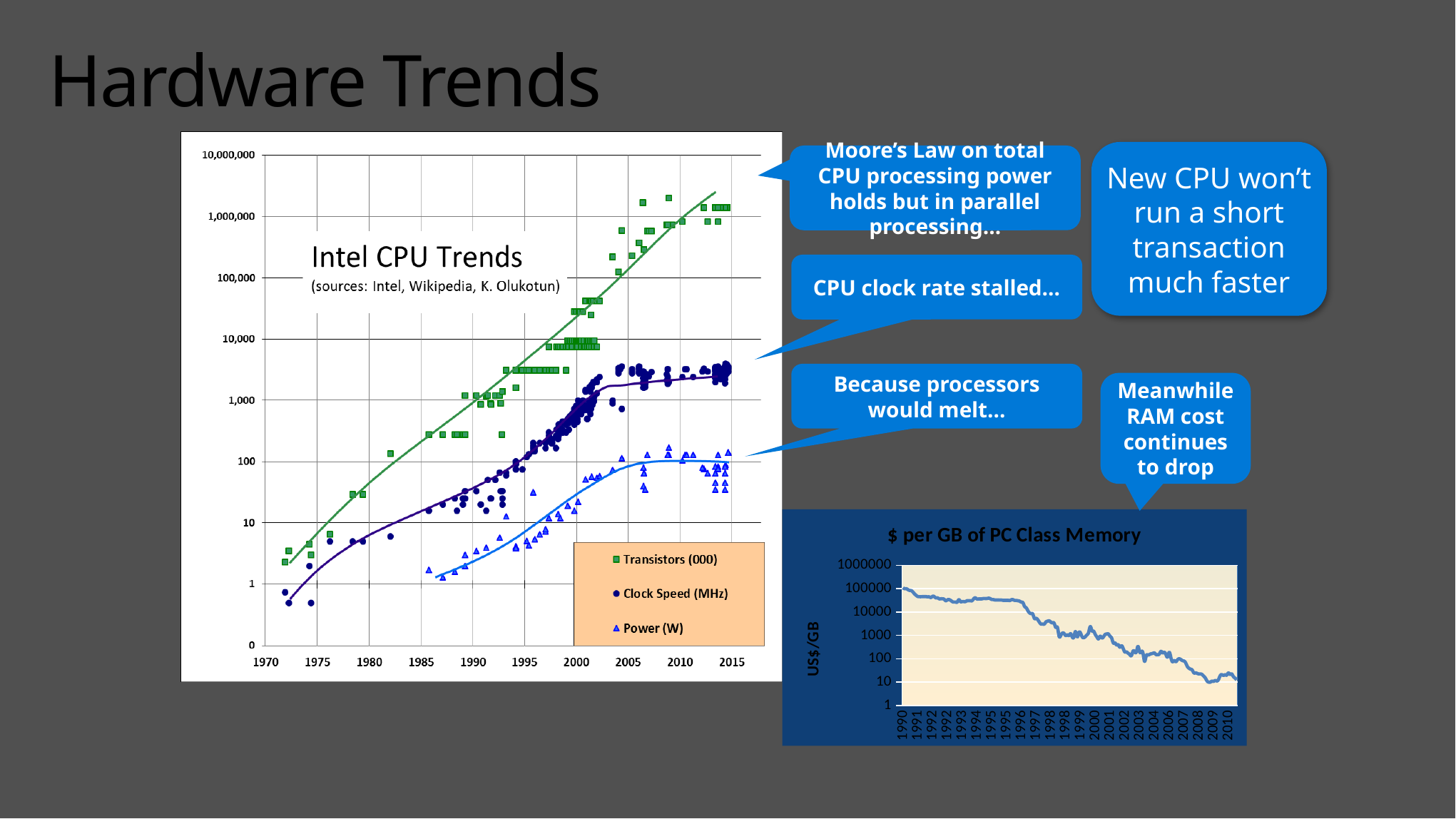
On the $ per GB of PC Class Memory chart, is the value in 2010 greater or less than 100? less On the Intel CPU Trends chart, is the Clock Speed (MHz) value around 2010 greater or less than 1,000? greater On the Intel CPU Trends chart, around 2010, which is larger: Clock Speed (MHz) or Power (W)? Clock Speed (MHz) On the Intel CPU Trends chart, what sources are cited under the title? Intel, Wikipedia, K. Olukotun On the Intel CPU Trends chart, how many series does the legend list? 3 On the $ per GB of PC Class Memory chart, do the values rise or fall from 1990 to 2010? fall On the Intel CPU Trends chart, is the Transistors (000) value around 2010 greater or less than 100,000? greater What kind of chart is the $ per GB of PC Class Memory chart? line chart What kind of chart is the Intel CPU Trends chart? scatter chart On the Intel CPU Trends chart, which series has the highest values around 2015? Transistors (000) On the Intel CPU Trends chart, do the Transistors (000) values rise or fall from 1970 to 2015? rise